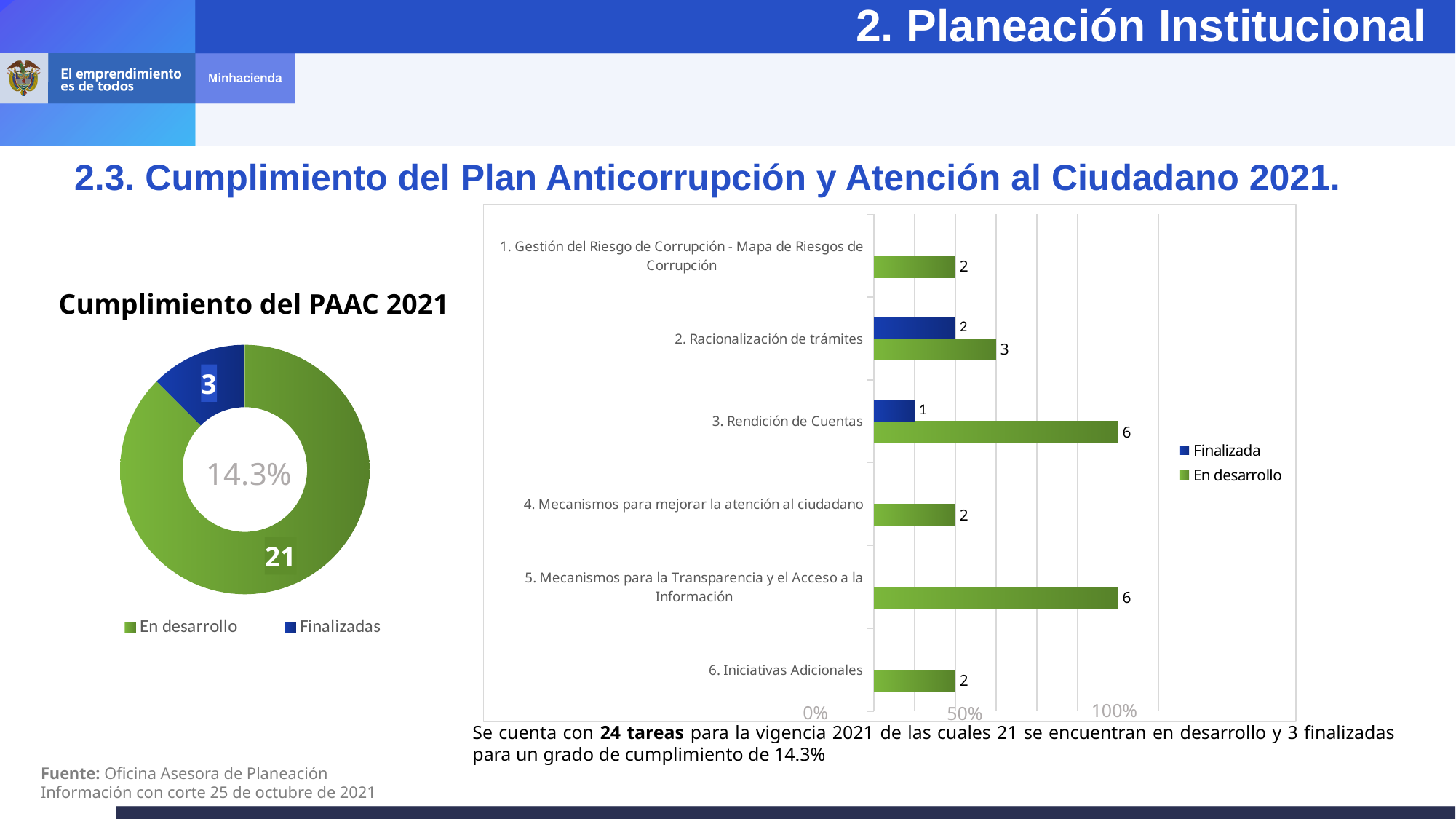
In the bar chart on the right, what is the difference between the 'En desarrollo' and 'Finalizada' values for '3. Rendición de Cuentas'? 5 In the bar chart on the right, what is the 'Finalizada' value for '2. Racionalización de trámites'? 2 In the donut chart 'Cumplimiento del PAAC 2021', what percentage is shown in the centre? 14.3% In the bar chart on the right, how many categories are shown? 6 In the donut chart 'Cumplimiento del PAAC 2021', what is the value for 'En desarrollo'? 21 In the donut chart 'Cumplimiento del PAAC 2021', what is the total of the two slices? 24 In the bar chart on the right, what is the 'En desarrollo' value for '3. Rendición de Cuentas'? 6 In the bar chart on the right, which category has the lowest 'Finalizada' value among those with a 'Finalizada' bar? 3. Rendición de Cuentas In the bar chart on the right, how many series does the legend list? 2 What kind of chart is the chart on the right side of the slide? Bar chart In the donut chart 'Cumplimiento del PAAC 2021', what is the value for 'Finalizadas'? 3 In the donut chart 'Cumplimiento del PAAC 2021', which slice is larger, 'En desarrollo' or 'Finalizadas'? En desarrollo